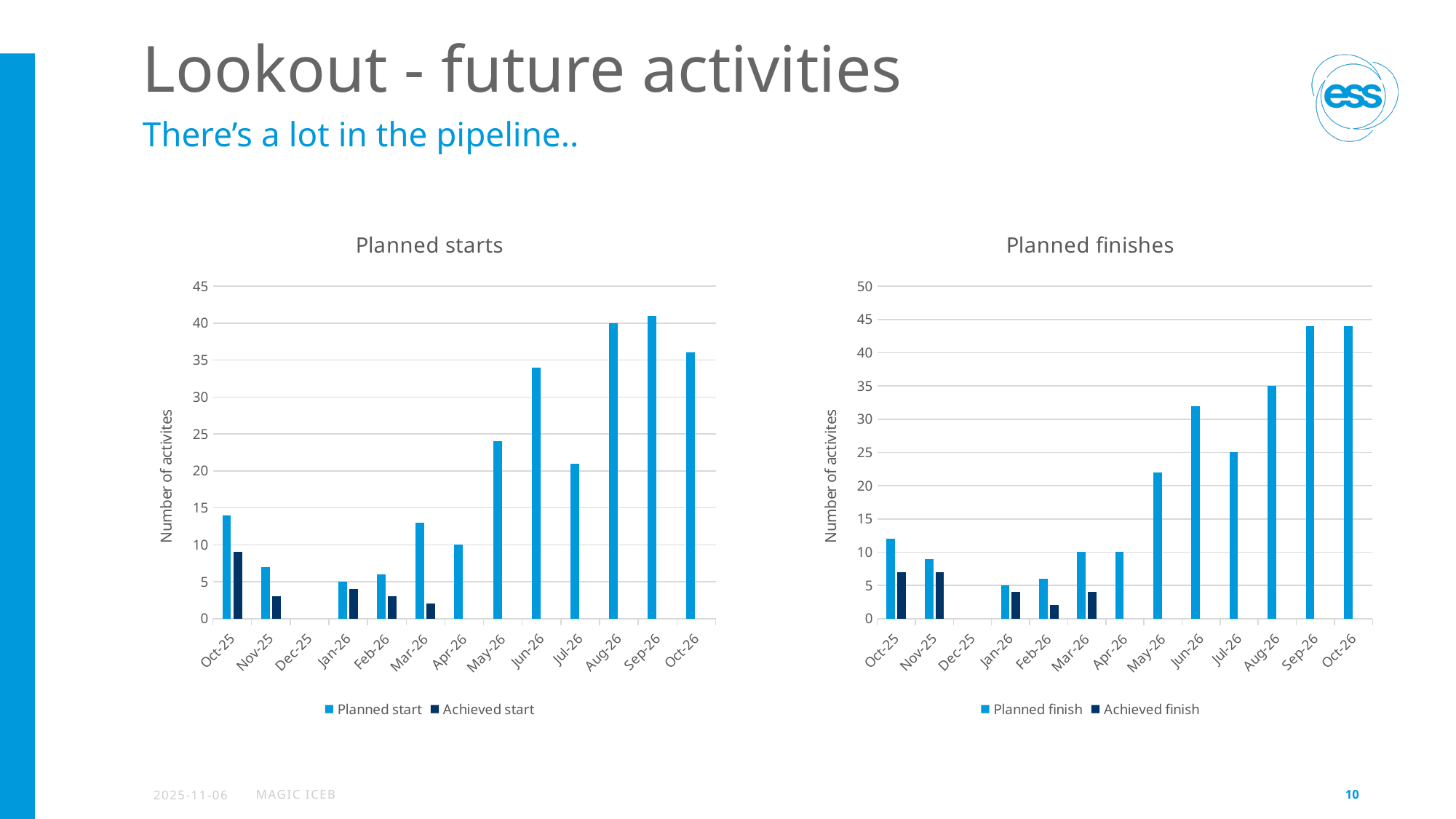
On the Planned finishes chart, what is the value of Planned finish for Aug-26? 35 On the Planned starts chart, is the Planned start value for Jun-26 greater or less than 30? greater On the Planned finishes chart, which is larger, the Planned finish value for Jun-26 or for May-26? Jun-26 What kind of chart is the Planned starts chart? Bar chart On the Planned starts chart, what is the value of Planned start for Aug-26? 40 How many months are shown on the x axis of the Planned starts chart? 13 On the Planned starts chart, what is the value of Planned start for Apr-26? 10 On the Planned finishes chart, is the Planned finish value for Sep-26 greater or less than 40? greater How many series does the legend of the Planned finishes chart list? 2 On the Planned finishes chart, what is the value of Planned finish for Jul-26? 25 What are the two legend entries on the Planned starts chart? Planned start and Achieved start On the Planned starts chart, which is larger, the Planned start value for May-26 or for Jul-26? May-26